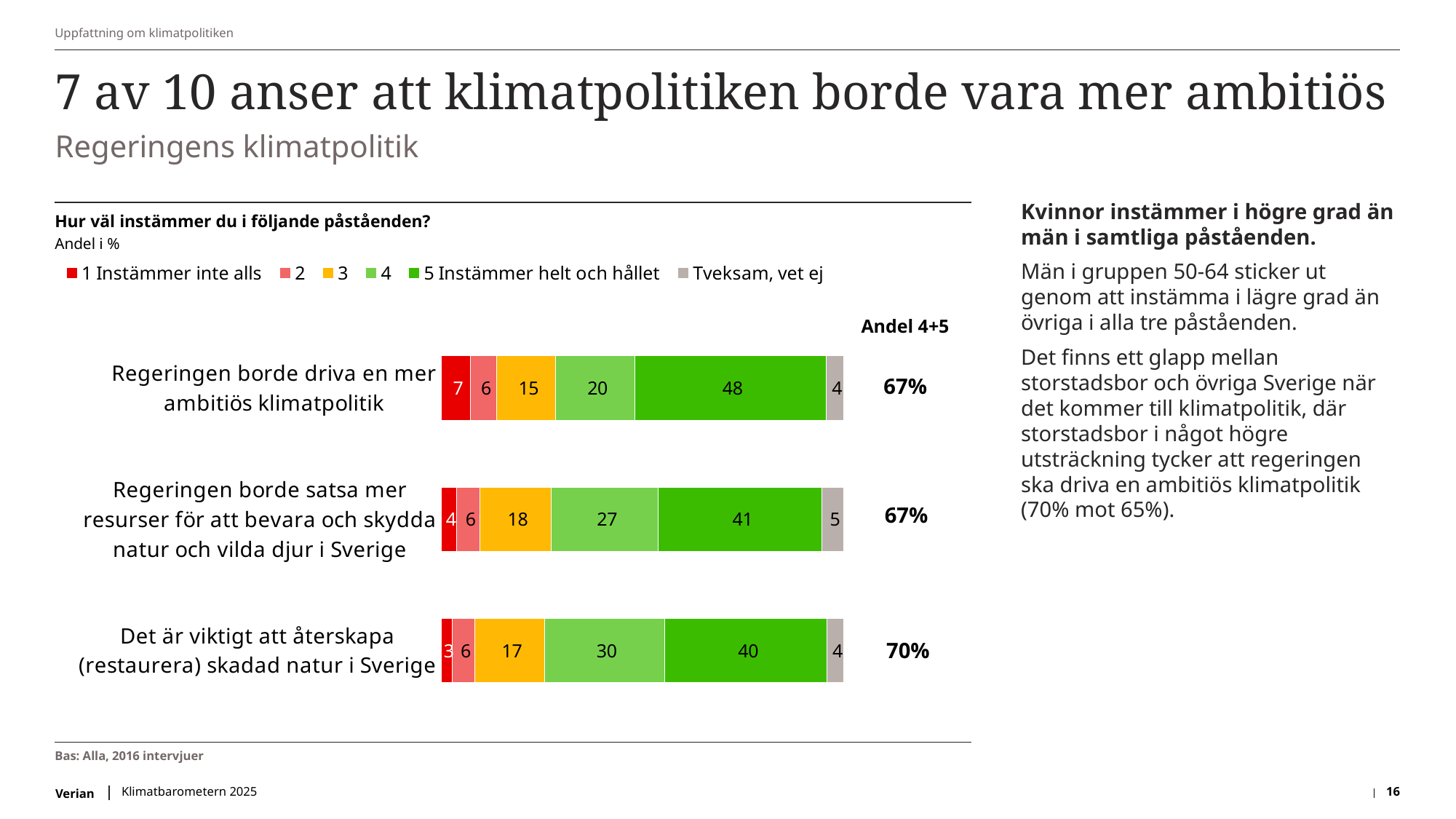
How many statements are shown in the chart? 3 What is the difference between the "5 Instämmer helt och hållet" values for "Regeringen borde driva en mer ambitiös klimatpolitik" and "Regeringen borde satsa mer resurser för att bevara och skydda natur och vilda djur i Sverige"? 7 What is the value for category "4" for the statement "Det är viktigt att återskapa (restaurera) skadad natur i Sverige"? 30 What is the total of all segments in the bar for "Regeringen borde driva en mer ambitiös klimatpolitik"? 100 What is the value for "5 Instämmer helt och hållet" for the statement "Regeringen borde driva en mer ambitiös klimatpolitik"? 48 What is the value for "Tveksam, vet ej" for the statement "Regeringen borde satsa mer resurser för att bevara och skydda natur och vilda djur i Sverige"? 5 What kind of chart is shown on the slide? Stacked bar chart How many series does the legend list? 6 Which statement has the lowest value for "1 Instämmer inte alls"? Det är viktigt att återskapa (restaurera) skadad natur i Sverige Which statement has the highest value for "5 Instämmer helt och hållet"? Regeringen borde driva en mer ambitiös klimatpolitik Which statement has the larger value for category "4": "Regeringen borde satsa mer resurser för att bevara och skydda natur och vilda djur i Sverige" or "Det är viktigt att återskapa (restaurera) skadad natur i Sverige"? Det är viktigt att återskapa (restaurera) skadad natur i Sverige What is the "Andel 4+5" shown for "Det är viktigt att återskapa (restaurera) skadad natur i Sverige"? 70%